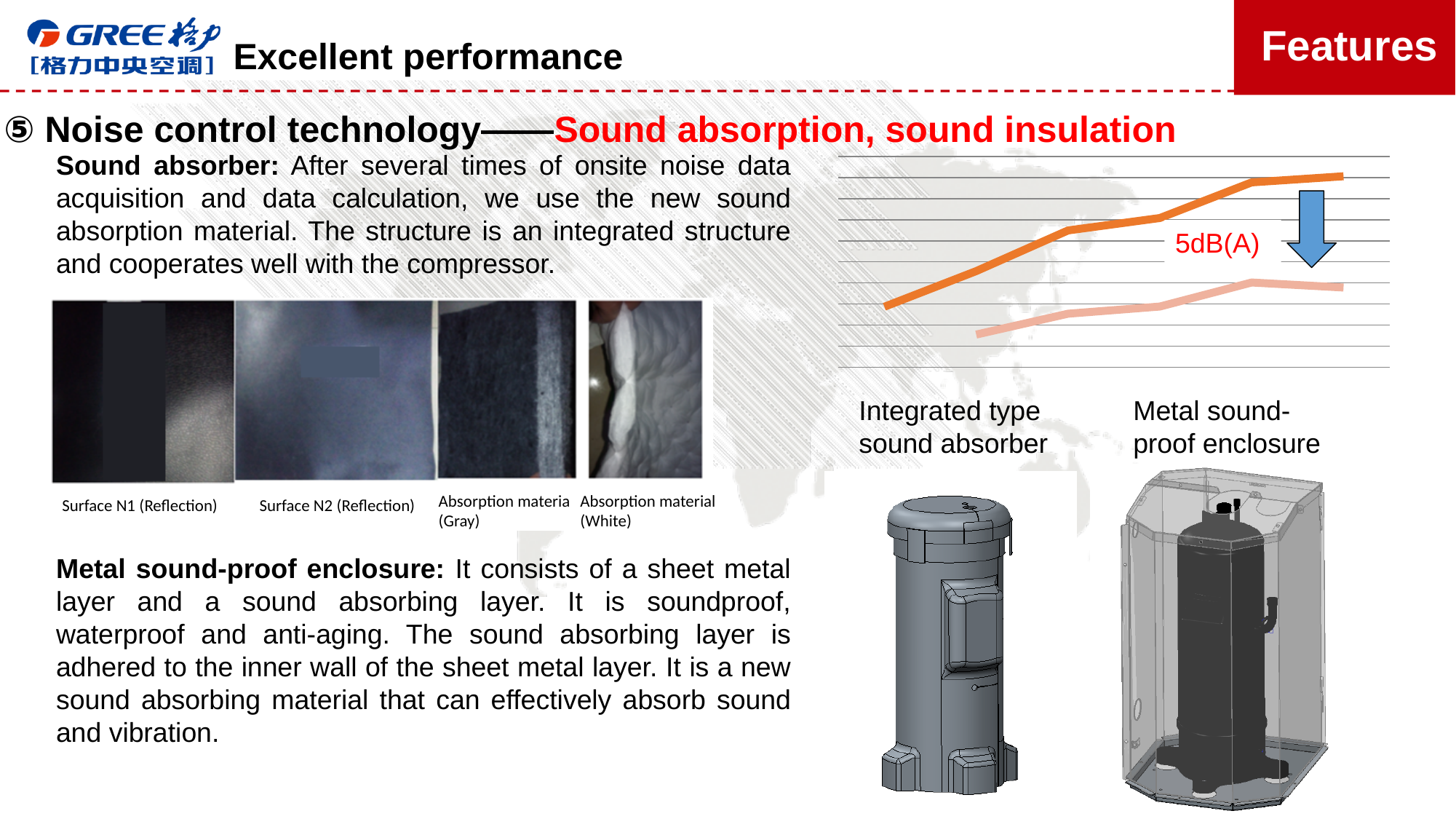
What kind of chart is shown at the top right of the slide? line chart What reduction value is annotated next to the arrow on the chart at the top right? 5dB(A) On the chart at the top right, do the values of the dark orange line rise or fall from left to right? rise How many lines are plotted on the chart at the top right of the slide? 2 On the chart at the top right, do the values of the light orange line rise or fall from left to right? rise In which direction does the blue arrow on the chart at the top right point? downward On the chart at the top right, which line sits higher: the dark orange line or the light orange line? the dark orange line